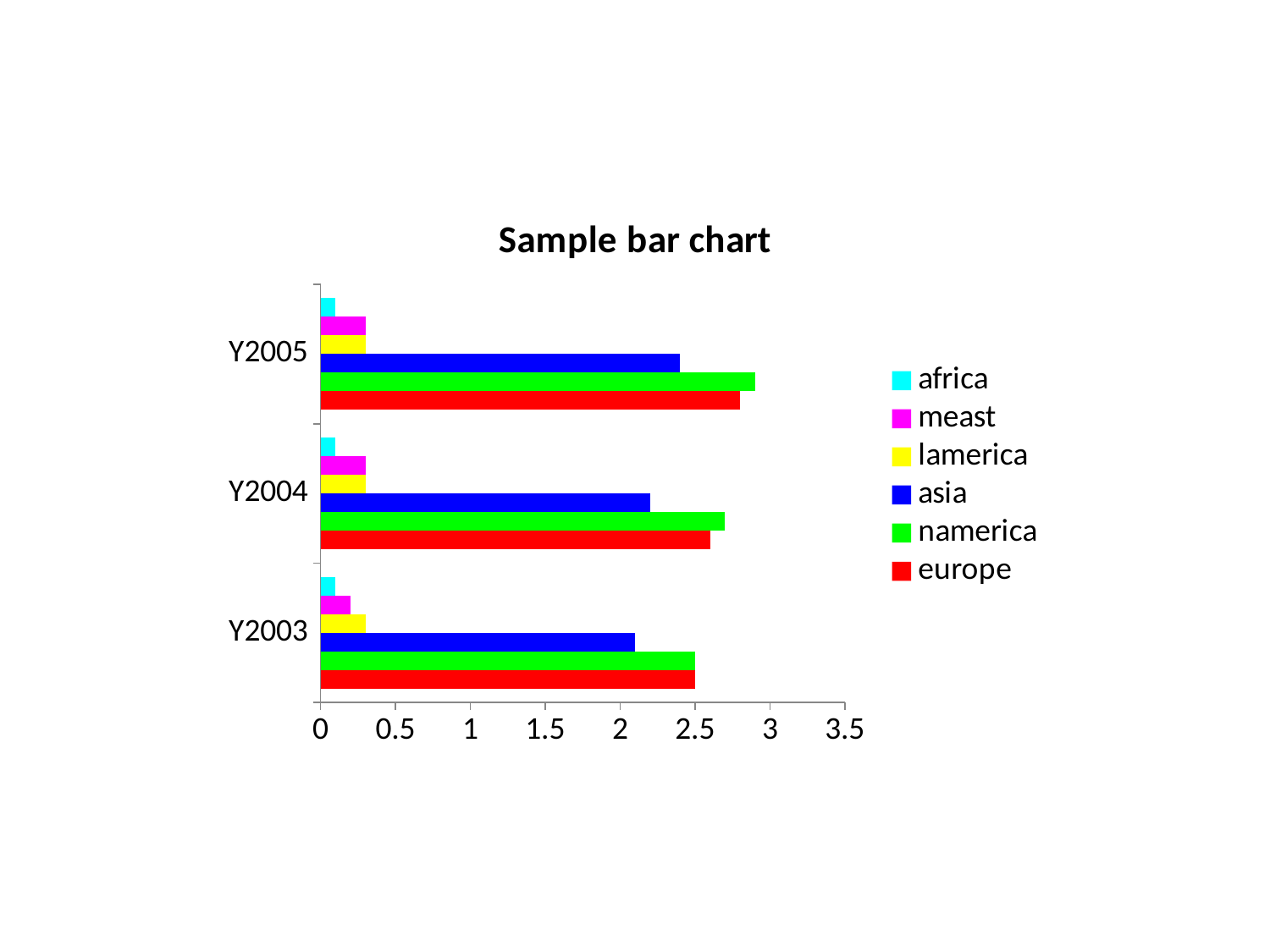
Which series is shown in red in the legend? europe In Y2005, which is larger, the value for namerica or the value for asia? namerica How many year categories are shown on the chart? 3 Which series has the lowest value in Y2005? africa Is the value for asia in Y2005 greater or less than 2? greater What kind of chart is shown on the slide? bar chart What is the title of the chart? Sample bar chart Is the value for africa in Y2004 greater or less than 0.5? less Is the value for namerica in Y2005 greater or less than 2.5? greater Does the value for europe rise or fall from Y2003 to Y2005? rises How many series does the legend list? 6 What is the value for europe in Y2003? 2.5